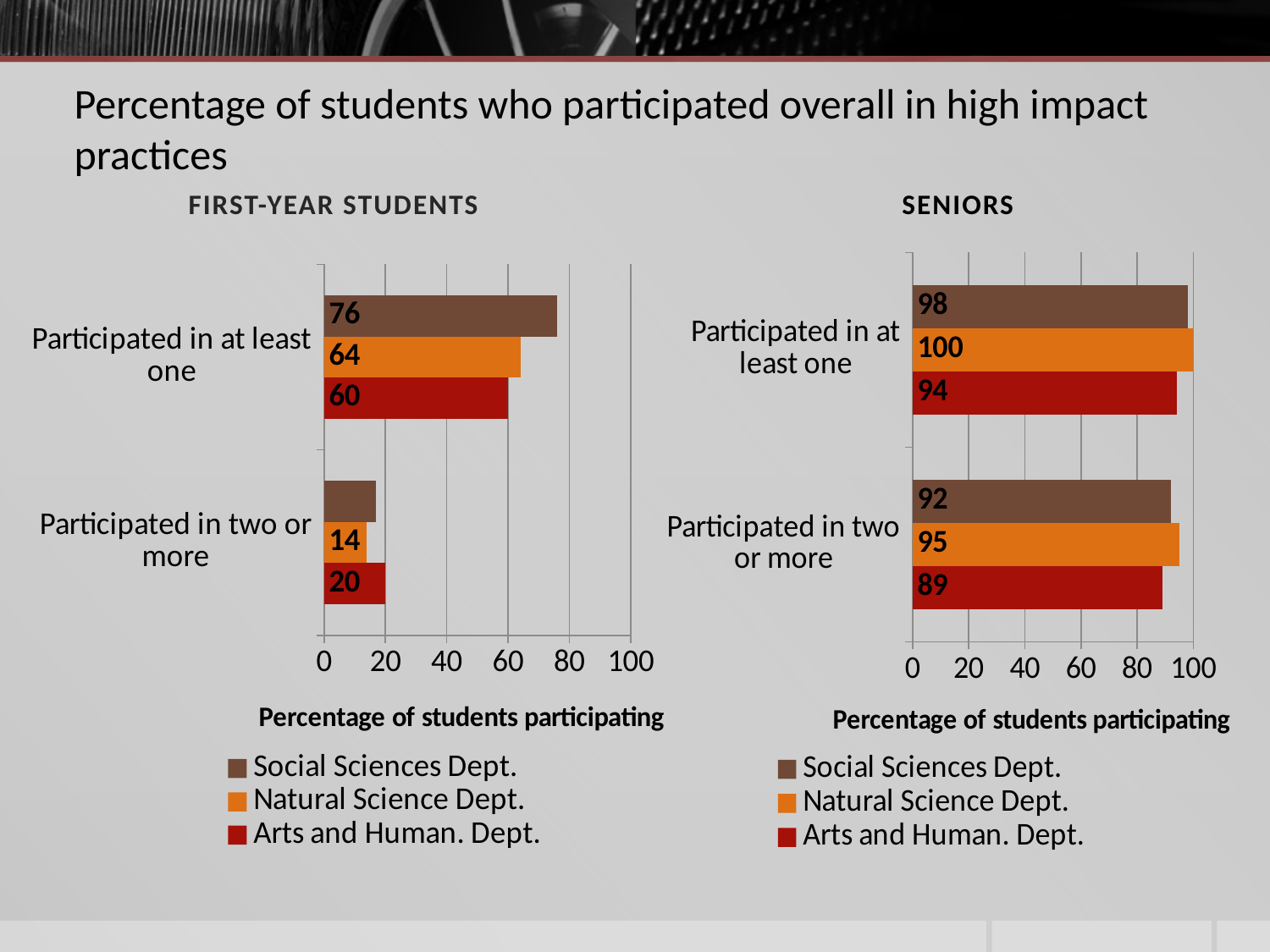
In the FIRST-YEAR STUDENTS chart, which department has the lowest value for 'Participated in at least one'? Arts and Human. Dept. What type of chart is the FIRST-YEAR STUDENTS chart? Bar chart In the FIRST-YEAR STUDENTS chart, what percentage of Social Sciences Dept. students participated in at least one high impact practice? 76 In the FIRST-YEAR STUDENTS chart, which is larger for 'Participated in two or more': Natural Science Dept. or Arts and Human. Dept.? Arts and Human. Dept. In the SENIORS chart, what is the value for Arts and Human. Dept. under 'Participated in at least one'? 94 In the SENIORS chart, what is the value for Natural Science Dept. under 'Participated in two or more'? 95 In the FIRST-YEAR STUDENTS chart, what is the difference between the Social Sciences Dept. and Arts and Human. Dept. values for 'Participated in at least one'? 16 How many series does the legend of the SENIORS chart list? 3 In the FIRST-YEAR STUDENTS chart, is the value for Social Sciences Dept. under 'Participated in two or more' greater or less than 40? less In the SENIORS chart, what is the difference between the Natural Science Dept. and Arts and Human. Dept. values for 'Participated in two or more'? 6 In the FIRST-YEAR STUDENTS chart, what is the value for Natural Science Dept. under 'Participated in two or more'? 14 In the SENIORS chart, which department has the highest value for 'Participated in at least one'? Natural Science Dept.